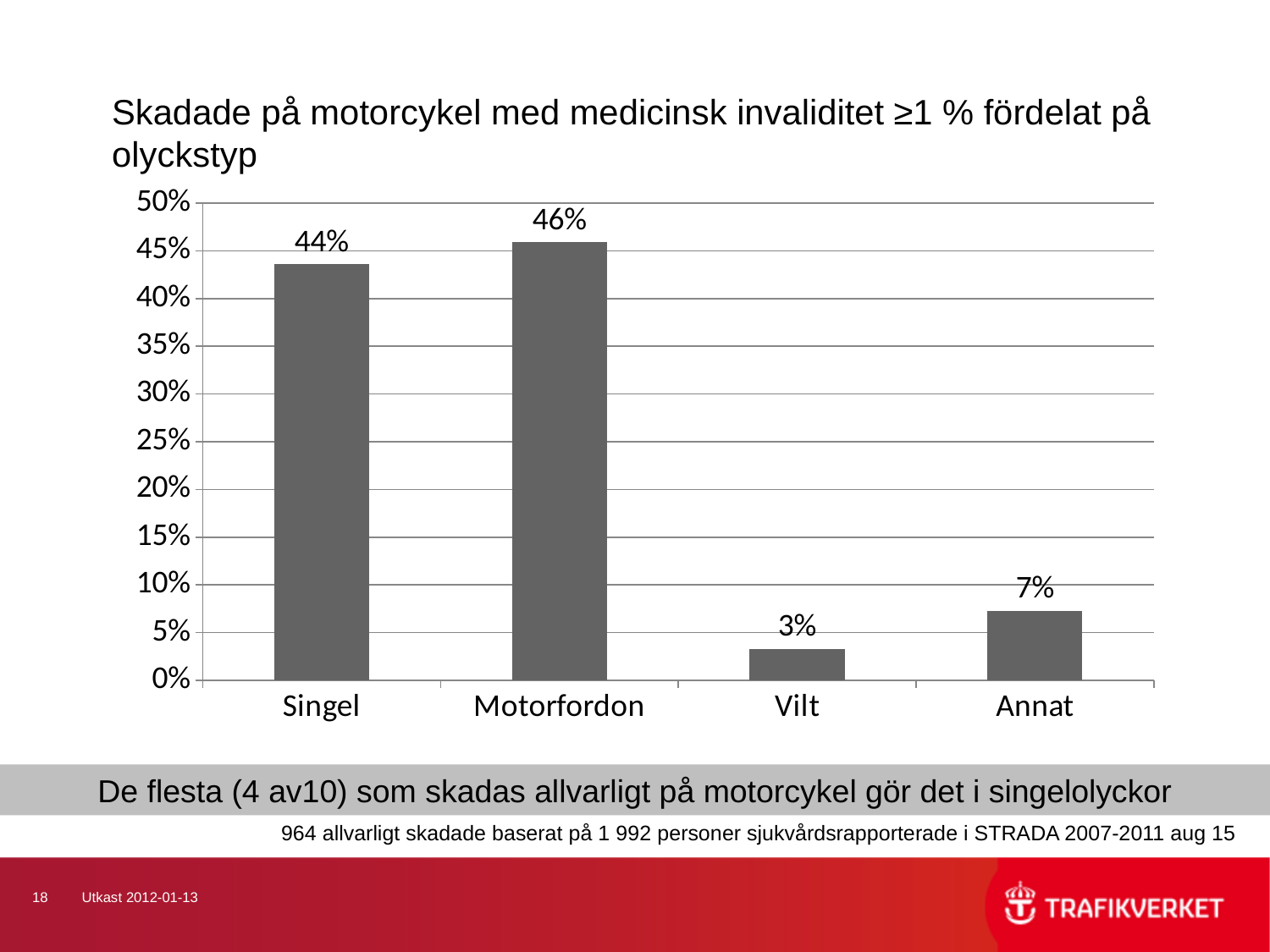
What is the value for Motorfordon? 46% Which is larger, the value for Annat or the value for Vilt? Annat Which category has the highest value? Motorfordon What kind of chart is shown on the slide? bar chart Which category has the lowest value? Vilt How many categories are shown on the x axis? 4 What is the value for Annat? 7% What is the value for Vilt? 3% What is the difference between the values for Annat and Vilt? 4% What is the difference between the values for Motorfordon and Singel? 2% Is the value for Singel greater or less than 40%? greater What is the value for Singel? 44%